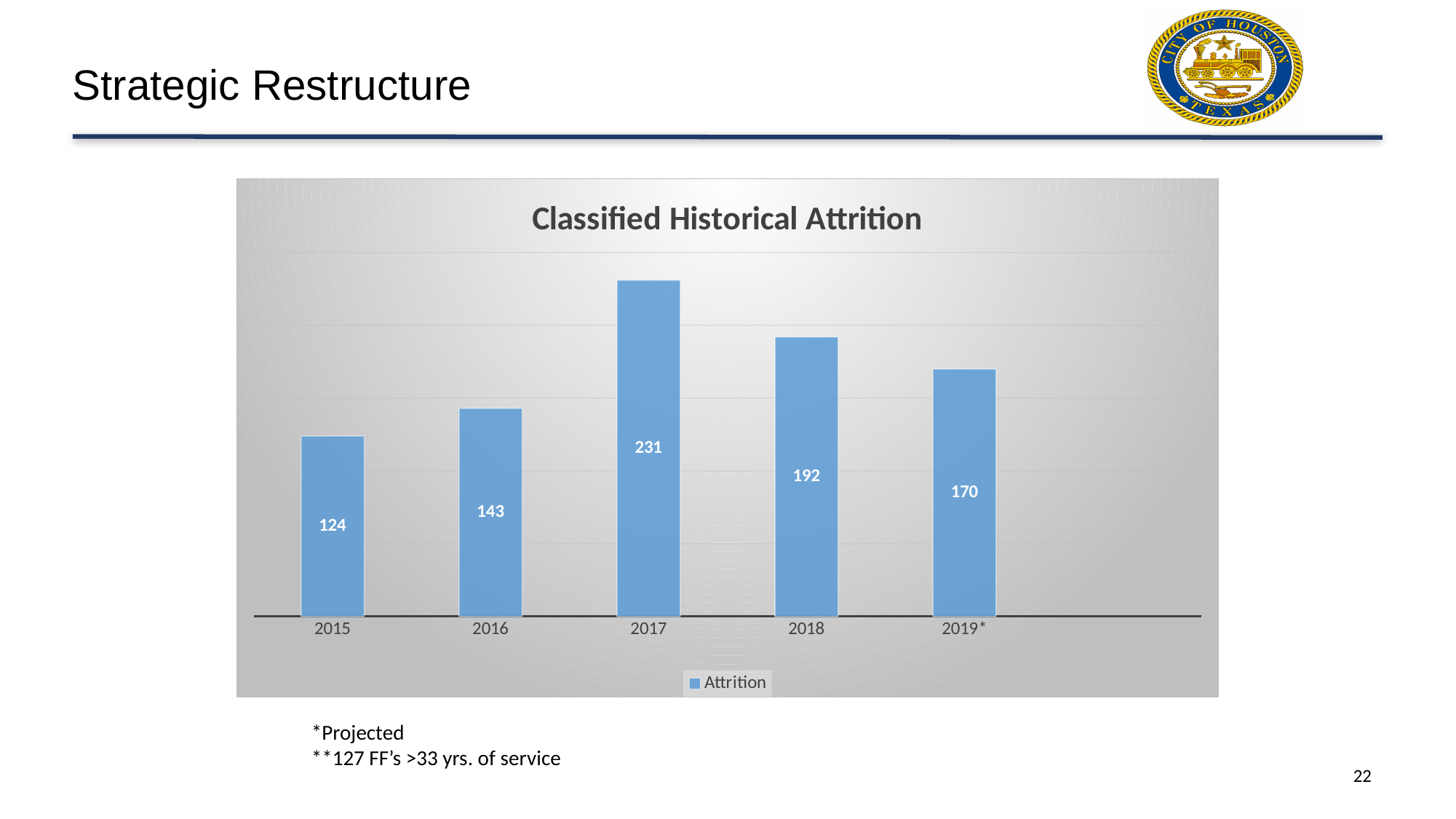
How many series does the legend list? 1 What is the attrition value for 2015? 124 What is the title of the chart? Classified Historical Attrition Which year has the lowest attrition? 2015 What is the difference in attrition between 2017 and 2018? 39 What is the difference in attrition between 2016 and 2015? 19 Which year has the highest attrition? 2017 Which year has higher attrition, 2018 or 2019*? 2018 What is the attrition value for 2019*? 170 How many years are shown on the x axis? 5 What kind of chart is shown? Bar chart What is the attrition value for 2017? 231